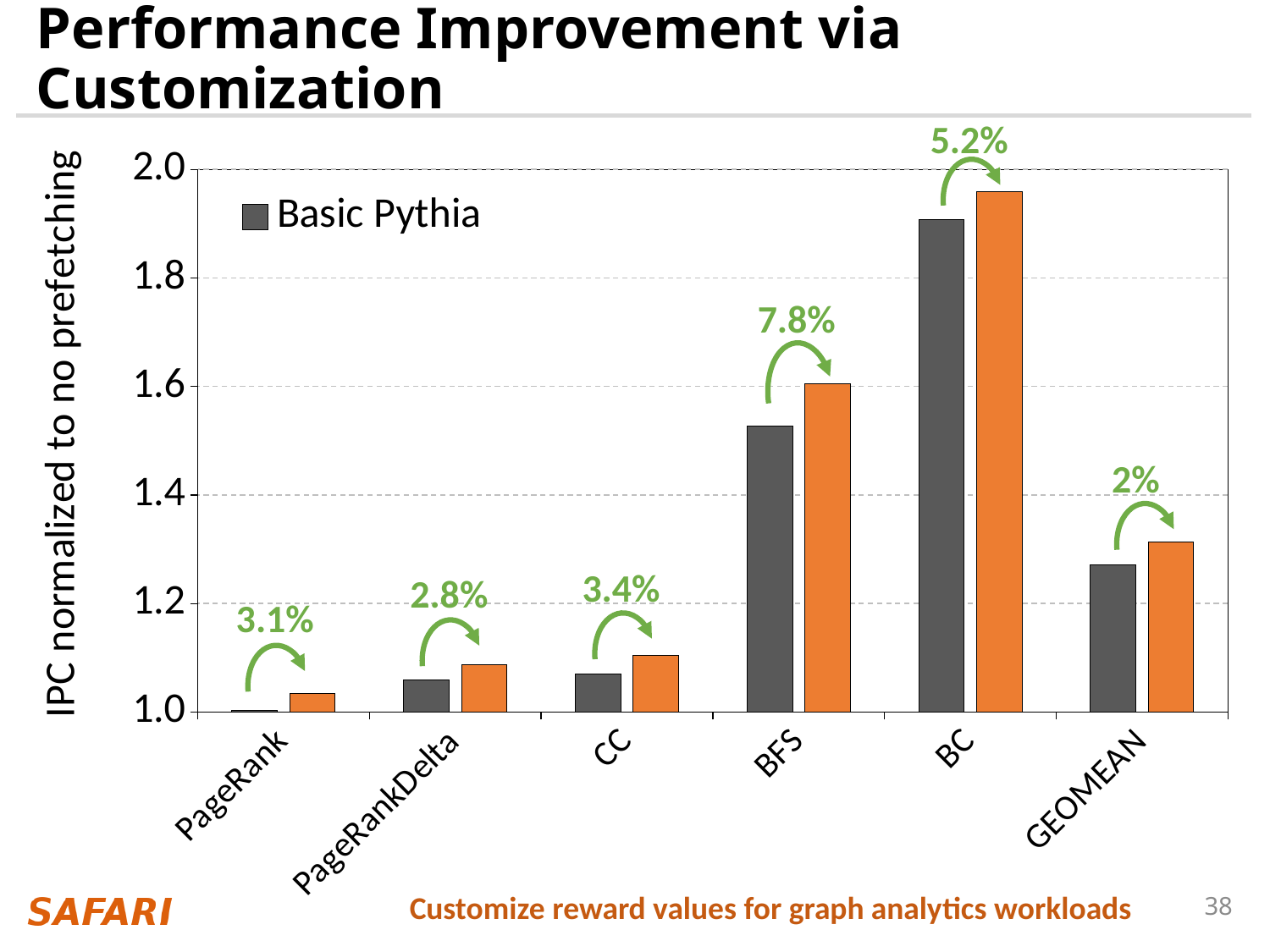
What improvement percentage is annotated above the PageRankDelta bars? 2.8% What improvement percentage is annotated above the GEOMEAN bars? 2% Is the Basic Pythia value for GEOMEAN greater or less than 1.4? less What improvement percentage is annotated above the BFS bars? 7.8% What is the name of the series listed in the legend? Basic Pythia Which workload has the lowest Basic Pythia IPC? PageRank What is the y-axis label of the chart? IPC normalized to no prefetching Which workload has the highest Basic Pythia IPC? BC How many workload categories are shown on the x axis? 6 How many series does the legend list? 1 Is the Basic Pythia value for BC greater or less than 1.8? greater What kind of chart is shown on the slide? bar chart